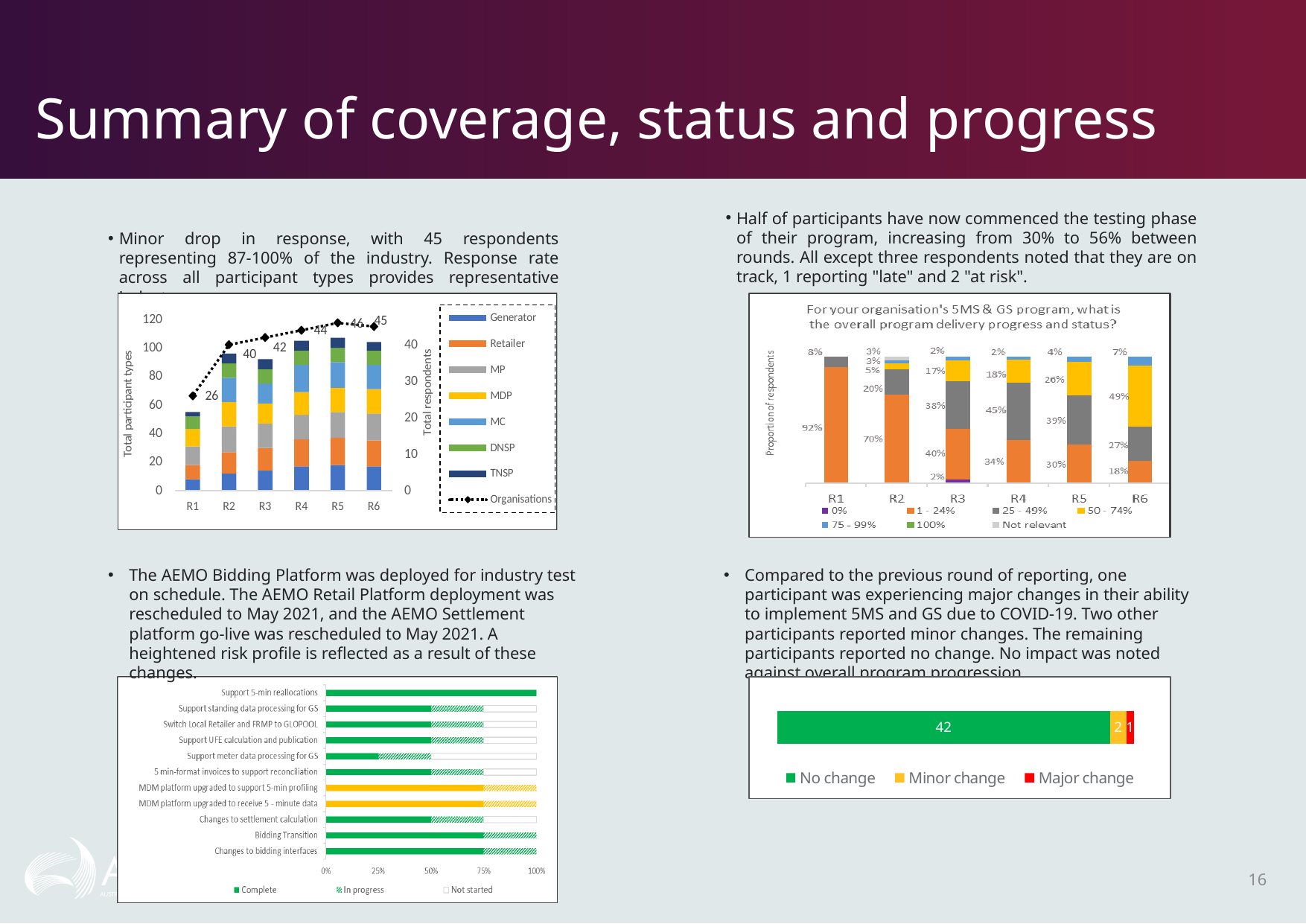
In the chart titled 'For your organisation's 5MS & GS program, what is the overall program delivery progress and status?', how many rounds are shown on the x axis? 6 In the top-left chart, how many series does the legend list? 8 In the top-left chart, what is the value of the Organisations line at R1? 26 In the bottom-left chart, how many categories are listed on the vertical axis? 11 In the bottom-right chart, what is the total of the stacked bar across No change, Minor change and Major change? 45 In the chart titled 'For your organisation's 5MS & GS program, what is the overall program delivery progress and status?', what is the 1 - 24% share for R1? 92% In the top-left chart, at which round does the Organisations line reach its highest value? R5 In the top-left chart, what is the value of the Organisations line at R6? 45 In the chart titled 'For your organisation's 5MS & GS program, what is the overall program delivery progress and status?', what is the 50 - 74% share for R6? 49% In the top-left chart, what is the difference between the Organisations values at R6 and R1? 19 In the bottom-right chart, what is the value for No change? 42 In the chart titled 'For your organisation's 5MS & GS program, what is the overall program delivery progress and status?', what is the difference between the 1 - 24% shares for R2 and R3? 30%